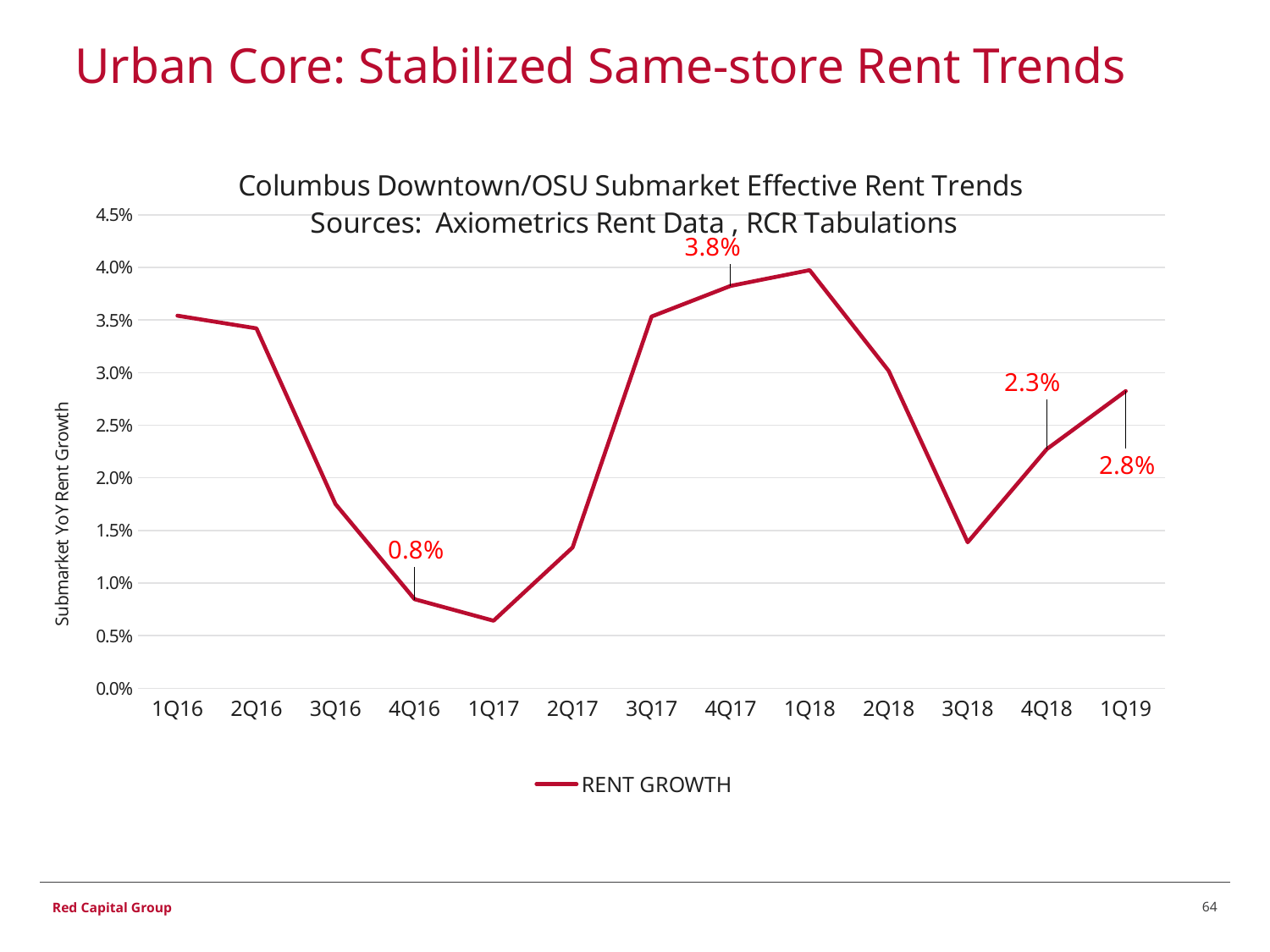
Is the rent growth value for 3Q18 greater or less than 2.0%? less What type of chart is shown on the slide? Line chart What is the difference between the labeled rent growth for 4Q17 and 4Q16? 3.0 percentage points What is the rent growth value labeled for 1Q19? 2.8% Which quarter has the highest rent growth on the chart? 1Q18 How many quarters are plotted on the x axis? 13 What is the rent growth value labeled for 4Q18? 2.3% What is the rent growth value labeled for 4Q17? 3.8% Does rent growth rise or fall from 1Q16 to 1Q17? Fall Which is larger, the rent growth for 4Q18 or for 1Q19? 1Q19 Is the rent growth value for 1Q16 greater or less than 3.0%? greater What is the rent growth value labeled for 4Q16? 0.8%